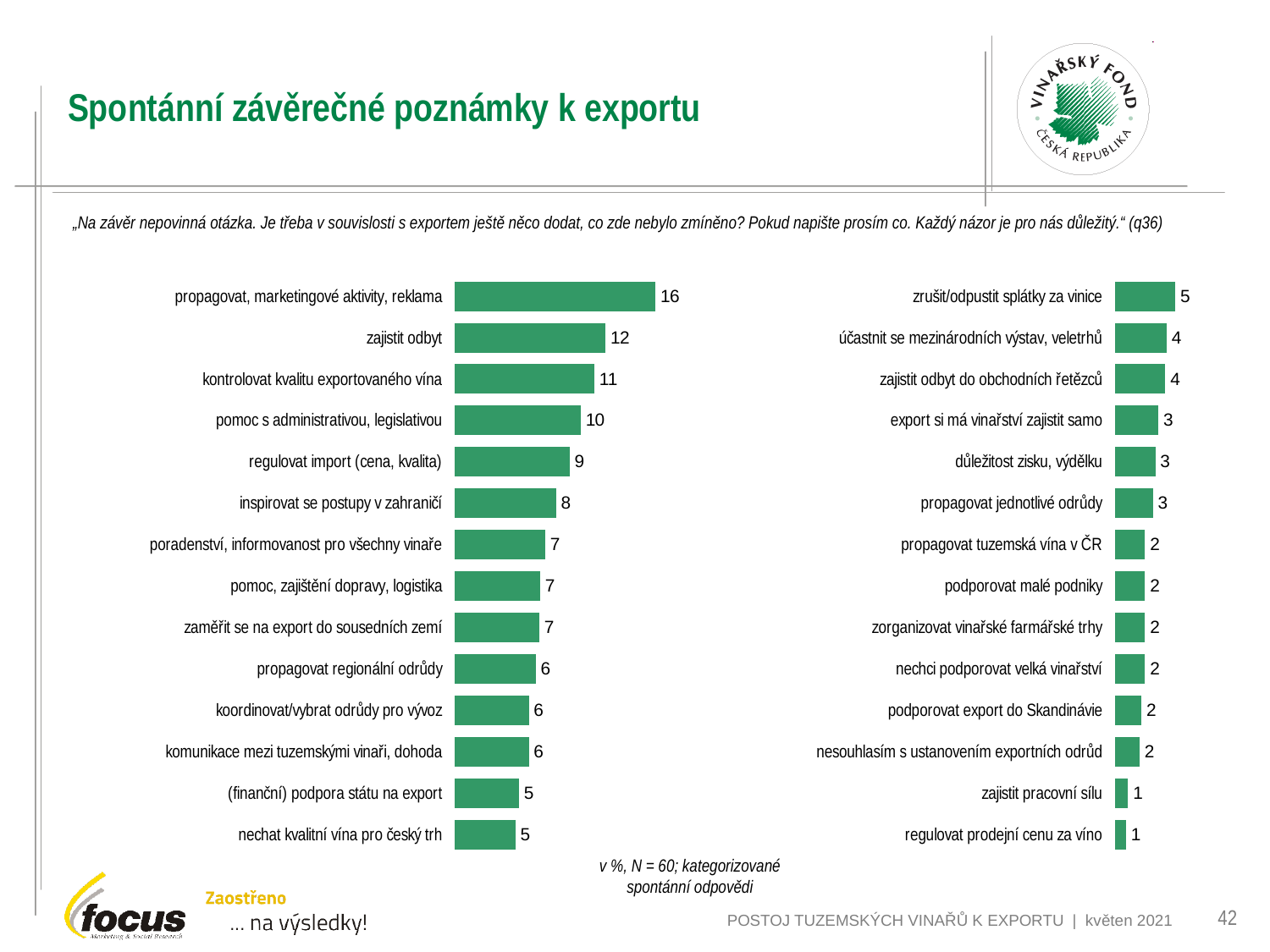
In the left chart, which is larger: "inspirovat se postupy v zahraničí" or "propagovat regionální odrůdy"? inspirovat se postupy v zahraničí In the left chart, what is the difference between "propagovat, marketingové aktivity, reklama" and "pomoc s administrativou, legislativou"? 6 How many categories are shown in the right chart? 14 What type of chart is the left chart? bar chart In the left chart, what is the value for "regulovat import (cena, kvalita)"? 9 In the left chart, what is the difference between "zajistit odbyt" and "kontrolovat kvalitu exportovaného vína"? 1 In the right chart, what is the value for "export si má vinařství zajistit samo"? 3 In the right chart, what is the value for "zrušit/odpustit splátky za vinice"? 5 In the right chart, which category has the highest value? zrušit/odpustit splátky za vinice In the left chart, which category has the highest value? propagovat, marketingové aktivity, reklama In the right chart, what is the value for "zajistit pracovní sílu"? 1 In the left chart, what is the value for "propagovat, marketingové aktivity, reklama"? 16